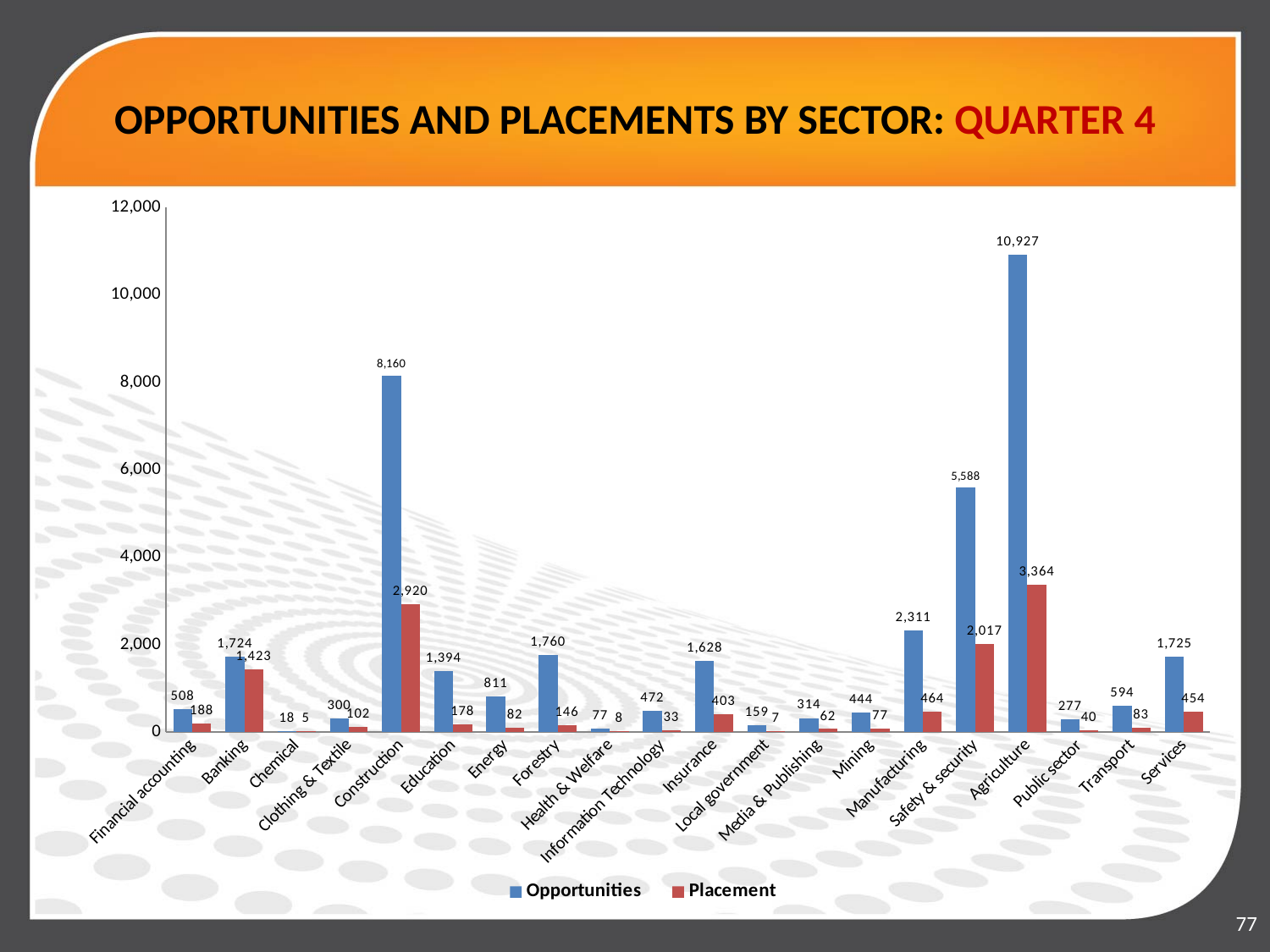
What is the Opportunities value for Construction? 8,160 Which sector has the lowest number of Opportunities? Chemical Which sector has the highest number of Opportunities? Agriculture What is the difference between Opportunities and Placement for Agriculture? 7,563 How many sectors are shown on the x axis? 20 How many series does the legend list? 2 Which series is shown in red in the legend? Placement Which sector has the larger Placement value, Construction or Safety & security? Construction Is the Opportunities value for Manufacturing greater or less than 2,000? greater What is the Placement value for Agriculture? 3,364 What kind of chart is shown on the slide? Bar chart What is the Placement value for Banking? 1,423